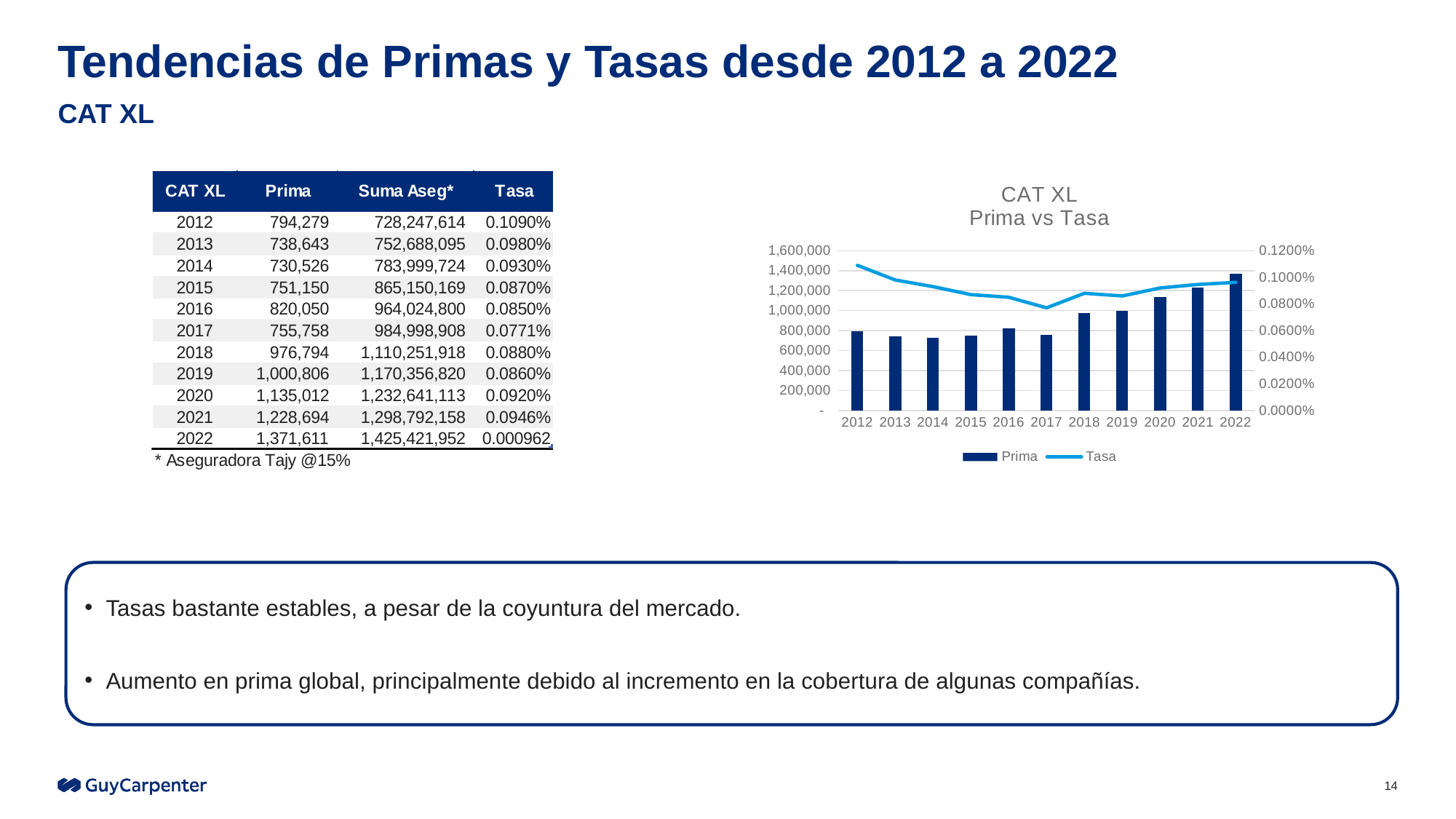
What kind of chart is shown on the right of the slide? Combined bar and line chart Is the Prima value for 2020 greater or less than 1,000,000? greater Is the Prima value for 2018 greater or less than 800,000? greater How many years are shown on the x axis of the chart? 11 In which year is the Tasa line at its highest point? 2012 Which year has the larger Prima bar, 2017 or 2018? 2018 In which year is the Tasa line at its lowest point? 2017 What is the title of the chart on the right? CAT XL Prima vs Tasa In which year is the Prima bar highest? 2022 How many series does the chart legend list? 2 Is the Tasa value for 2012 greater or less than 0.1000%? greater Which series in the chart is drawn as a line? Tasa